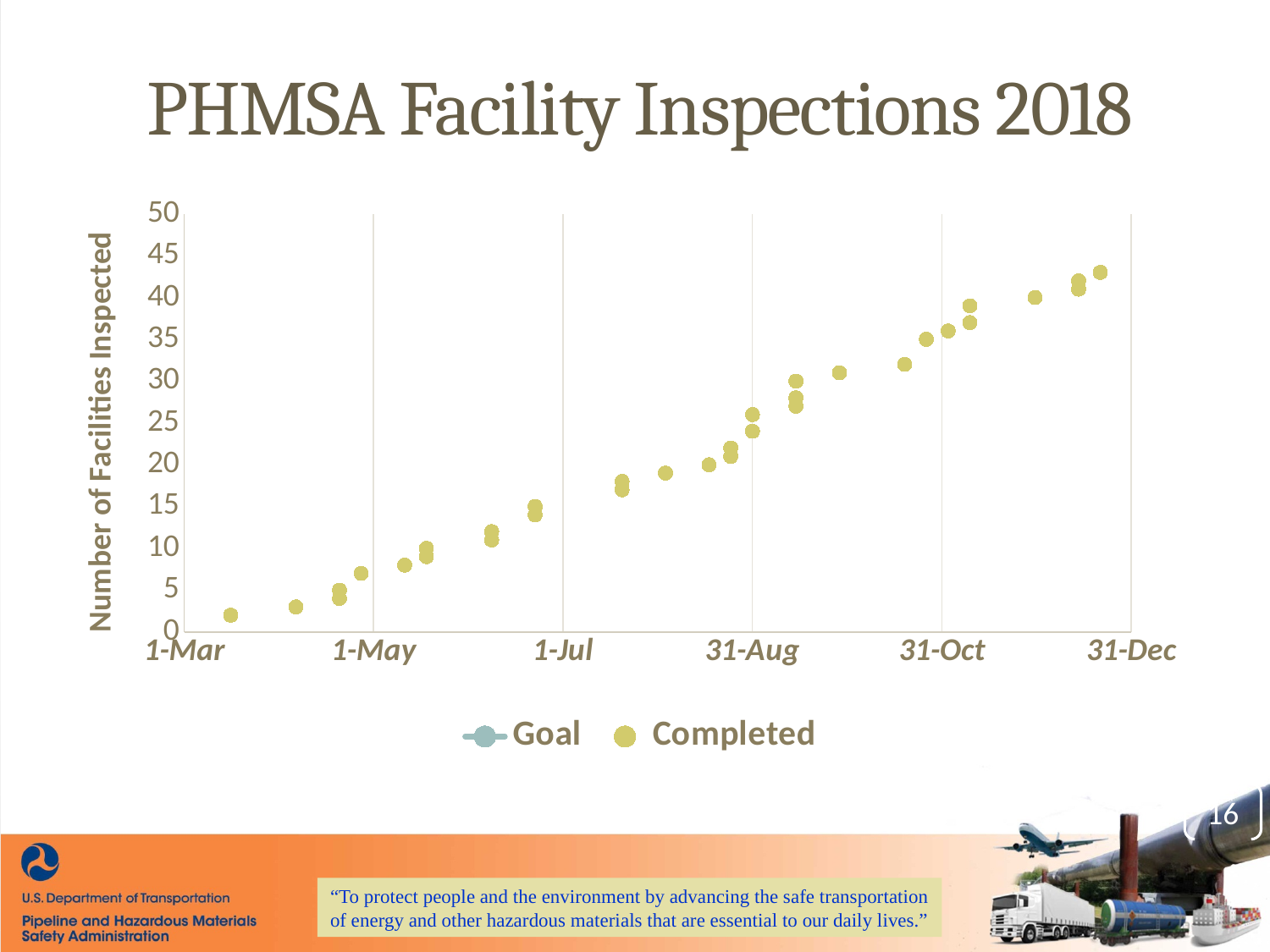
Is the Completed value at the point nearest 31-Oct greater or less than 30? greater Is the Completed value at the point nearest 31-Aug greater or less than 20? greater Is the Completed value at the point nearest 1-Jul greater or less than 20? less Do the Completed values rise or fall from 1-Mar to 31-Dec? rise How many series does the legend list? 2 What kind of chart is shown on the slide? scatter chart Around which x-axis date does the Completed series reach its highest value? 31-Dec What is the title of the chart? PHMSA Facility Inspections 2018 Which is larger, the Completed value near 1-May or the Completed value near 31-Oct? 31-Oct What are the two series named in the legend? Goal and Completed